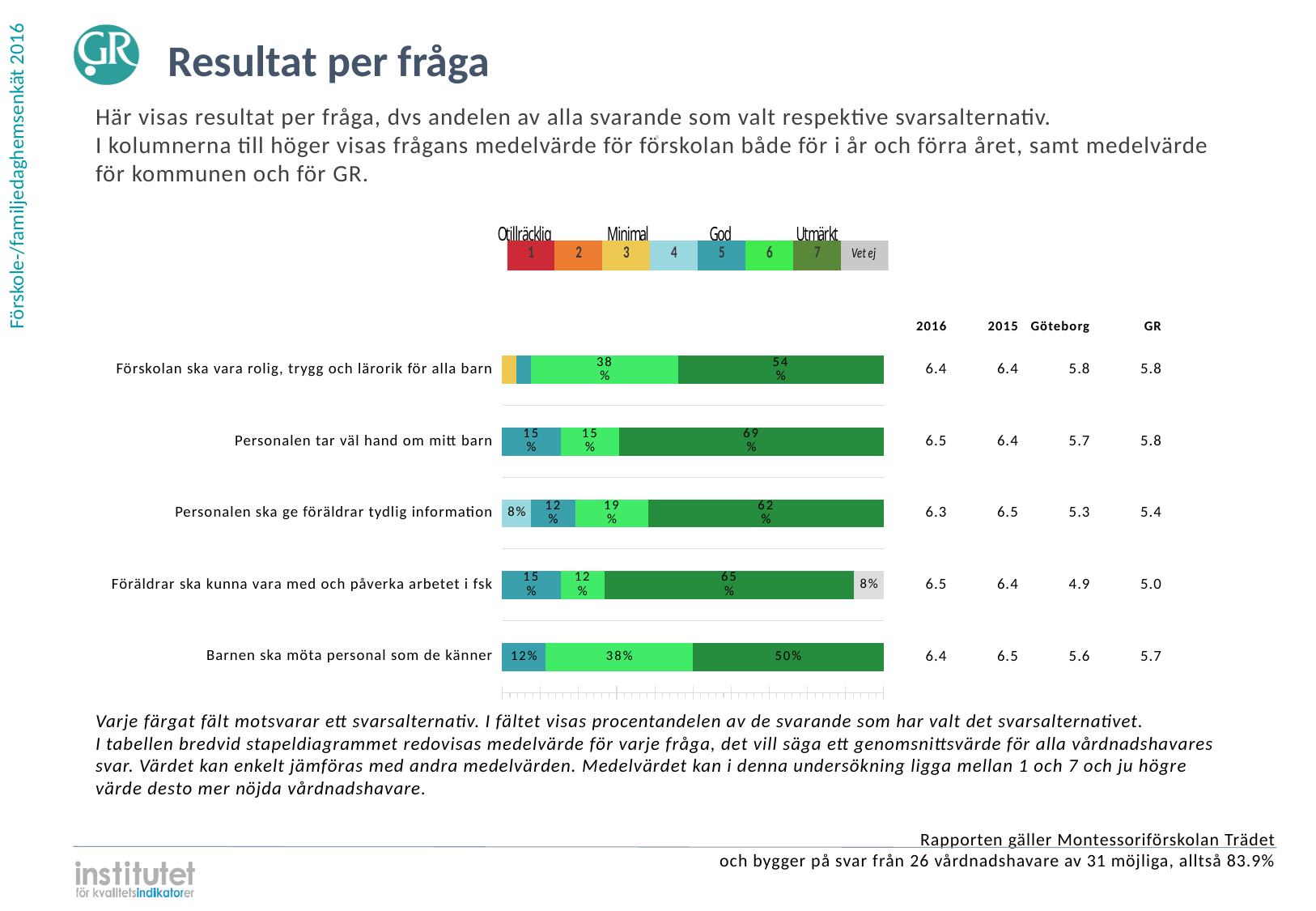
What percentage is shown for the grey 'Vet ej' segment of 'Föräldrar ska kunna vara med och påverka arbetet i fsk'? 8% What percentage of respondents chose the dark green option (7, Utmärkt) for 'Personalen tar väl hand om mitt barn'? 69% Which question has the highest share of respondents choosing the dark green option (7)? Personalen tar väl hand om mitt barn How many percentage points higher is the dark green share for 'Personalen tar väl hand om mitt barn' than for 'Förskolan ska vara rolig, trygg och lärorik för alla barn'? 15 percentage points Which has a larger dark green share: 'Personalen ska ge föräldrar tydlig information' or 'Föräldrar ska kunna vara med och påverka arbetet i fsk'? Föräldrar ska kunna vara med och påverka arbetet i fsk What percentage is shown for the light green segment (6) of 'Förskolan ska vara rolig, trygg och lärorik för alla barn'? 38% In the legend above the chart, what label is given to response option 7? Utmärkt Which question has the lowest share of respondents choosing the dark green option (7)? Barnen ska möta personal som de känner What percentage is shown for the light blue segment (4) of 'Personalen ska ge föräldrar tydlig information'? 8% What kind of chart is used to show the results per question? Stacked horizontal bar chart What percentage is shown for the dark green segment of 'Barnen ska möta personal som de känner'? 50% How many questions (bars) are shown in the chart? 5